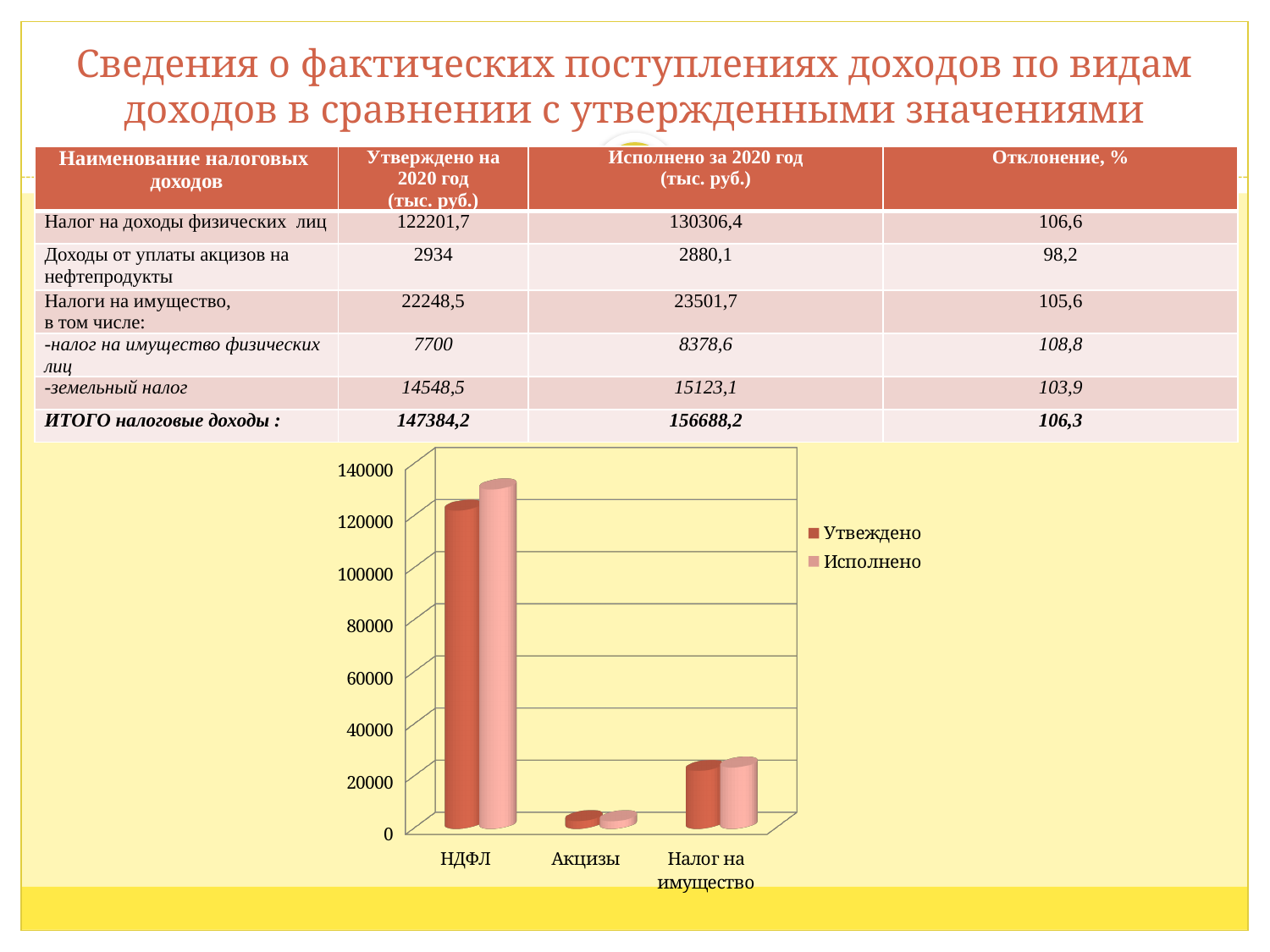
Which category has the lowest bars in the chart? Акцизы How many categories are shown on the x axis of the chart? 3 Which category has the highest bars in the chart? НДФЛ Is the Утвеждено value for Акцизы greater or less than 20000? less Is the Исполнено value for НДФЛ greater or less than 120000? greater What is the highest value shown on the chart's vertical axis? 140000 Is the Утвеждено value for НДФЛ greater or less than 100000? greater How many series does the chart legend list? 2 What are the two series names listed in the chart legend? Утвеждено, Исполнено For НДФЛ, which is larger: Утвеждено or Исполнено? Исполнено What kind of chart is shown on the slide? bar chart